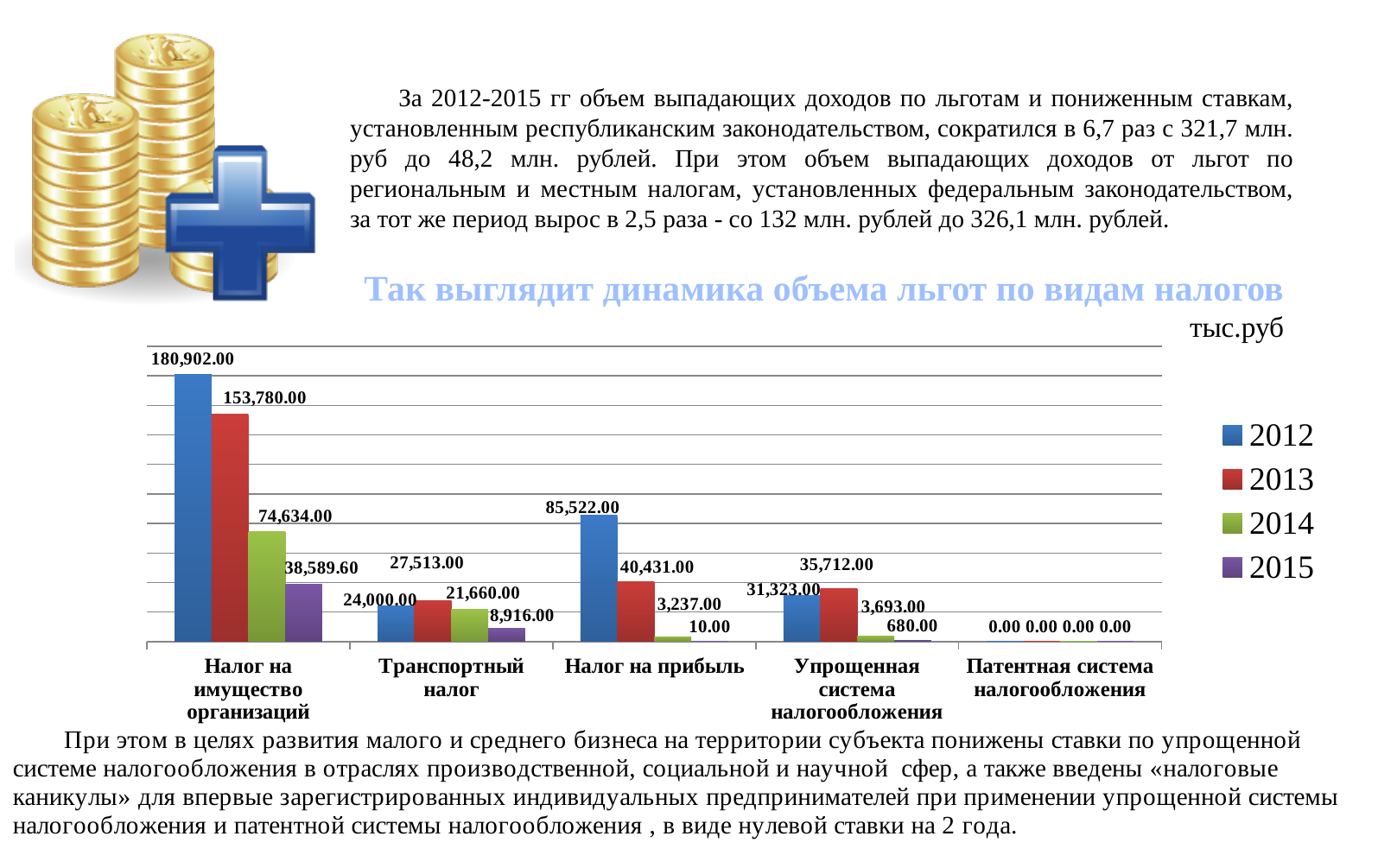
How many series does the chart legend list? 4 Which tax category has the highest 2012 value? Налог на имущество организаций What is the 2012 value for Налог на имущество организаций? 180,902.00 How many tax categories are shown on the x axis of the chart? 5 What type of chart is shown on the slide? bar chart What is the 2013 value for Упрощенная система налогообложения? 35,712.00 For Транспортный налог, which is larger: the 2012 value or the 2013 value? 2013 Which tax category has the lowest 2014 value? Патентная система налогообложения What is the 2015 value for Налог на прибыль? 10.00 What is the difference between the 2012 and 2013 values for Налог на имущество организаций? 27,122.00 Do the values for Налог на прибыль rise or fall from 2012 to 2015? fall What unit is indicated above the chart? тыс.руб